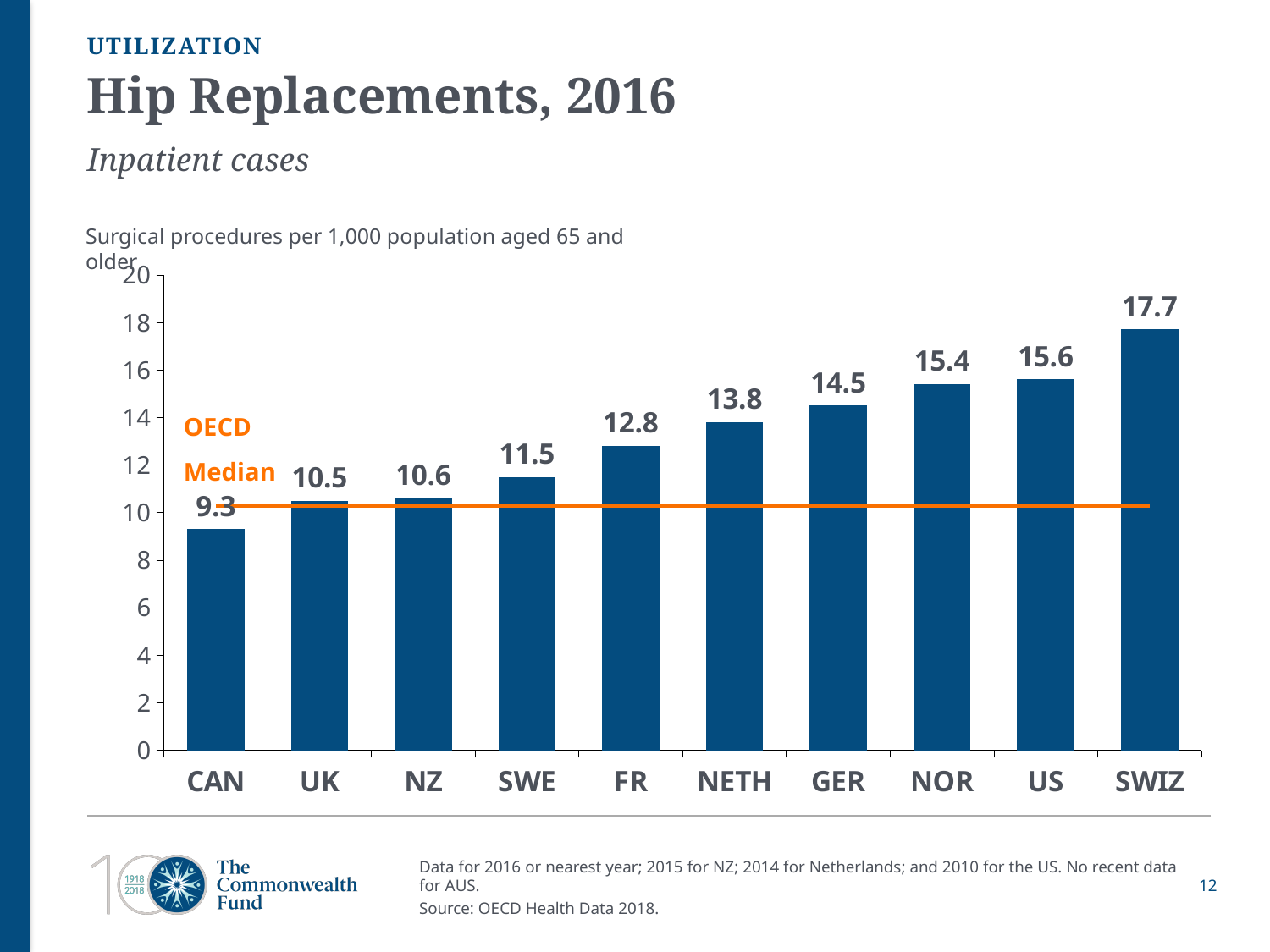
What is the value for CAN? 9.3 What kind of chart is this? Bar chart Which is larger, the value for FR or the value for SWE? FR Do the values rise or fall from left to right along the x axis? Rise How many countries are shown on the chart? 10 What is the difference between the values for SWIZ and CAN? 8.4 What is the value for NETH? 13.8 What is the difference between the values for US and NOR? 0.2 Which country has the lowest value? CAN Which country has the highest value? SWIZ Is the value for GER greater or less than 14? greater What is the value for the US? 15.6